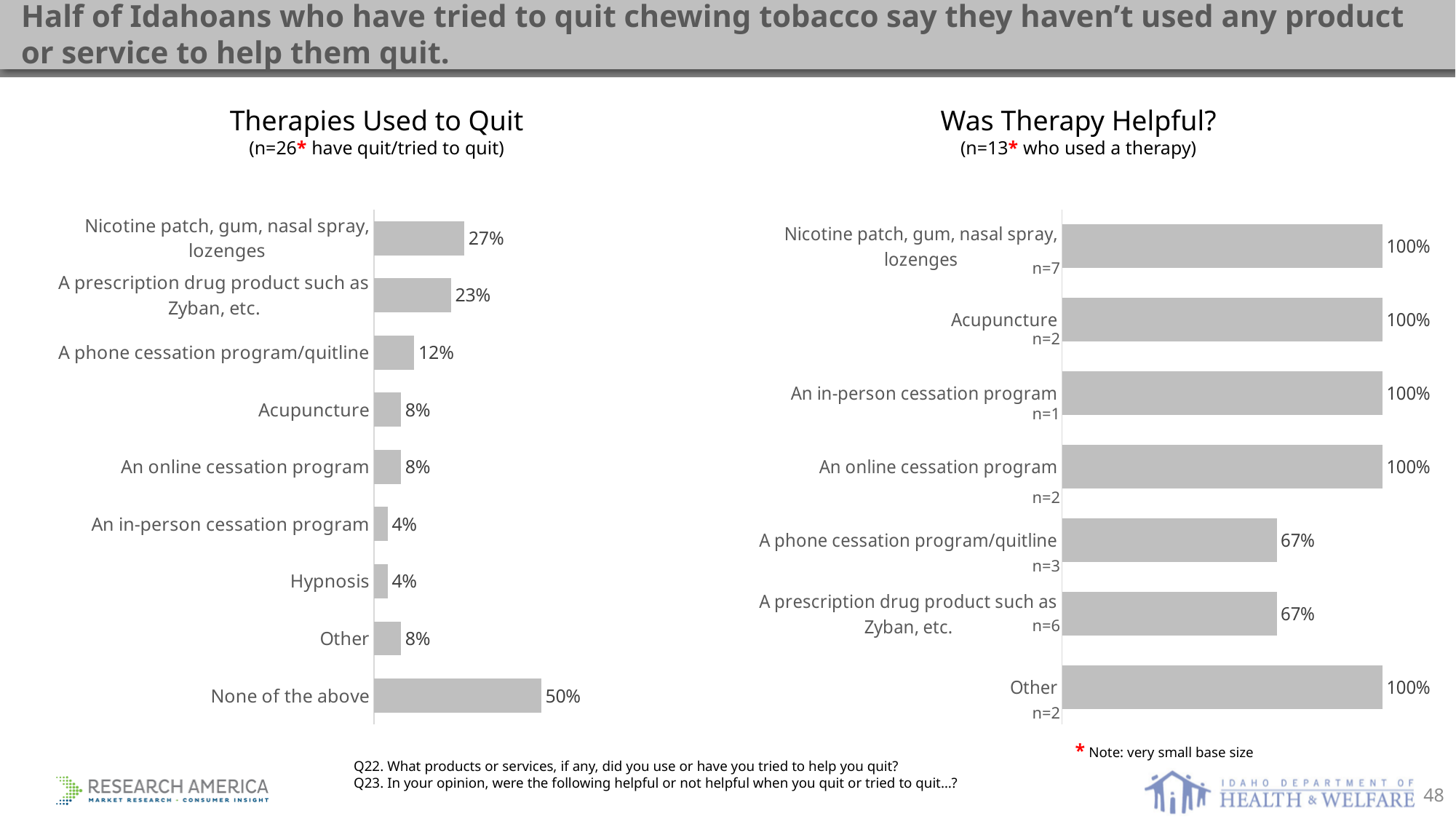
In the 'Therapies Used to Quit' chart, what is the value for 'A prescription drug product such as Zyban, etc.'? 23% In the 'Therapies Used to Quit' chart, what is the difference between 'Nicotine patch, gum, nasal spray, lozenges' and 'A phone cessation program/quitline'? 15% How many categories are shown in the 'Therapies Used to Quit' chart? 9 In the 'Therapies Used to Quit' chart, which is larger: 'Acupuncture' or 'Hypnosis'? Acupuncture In the 'Was Therapy Helpful?' chart, what is the value for 'A phone cessation program/quitline'? 67% What is the sample size (n) noted under the title of the 'Was Therapy Helpful?' chart? n=13 In the 'Therapies Used to Quit' chart, what is the value for 'None of the above'? 50% In the 'Was Therapy Helpful?' chart, what is the value for 'Acupuncture'? 100% How many categories are shown in the 'Was Therapy Helpful?' chart? 7 In the 'Was Therapy Helpful?' chart, which is larger: 'An online cessation program' or 'A prescription drug product such as Zyban, etc.'? An online cessation program In the 'Therapies Used to Quit' chart, which category has the highest value? None of the above What kind of chart is the 'Was Therapy Helpful?' chart? Bar chart